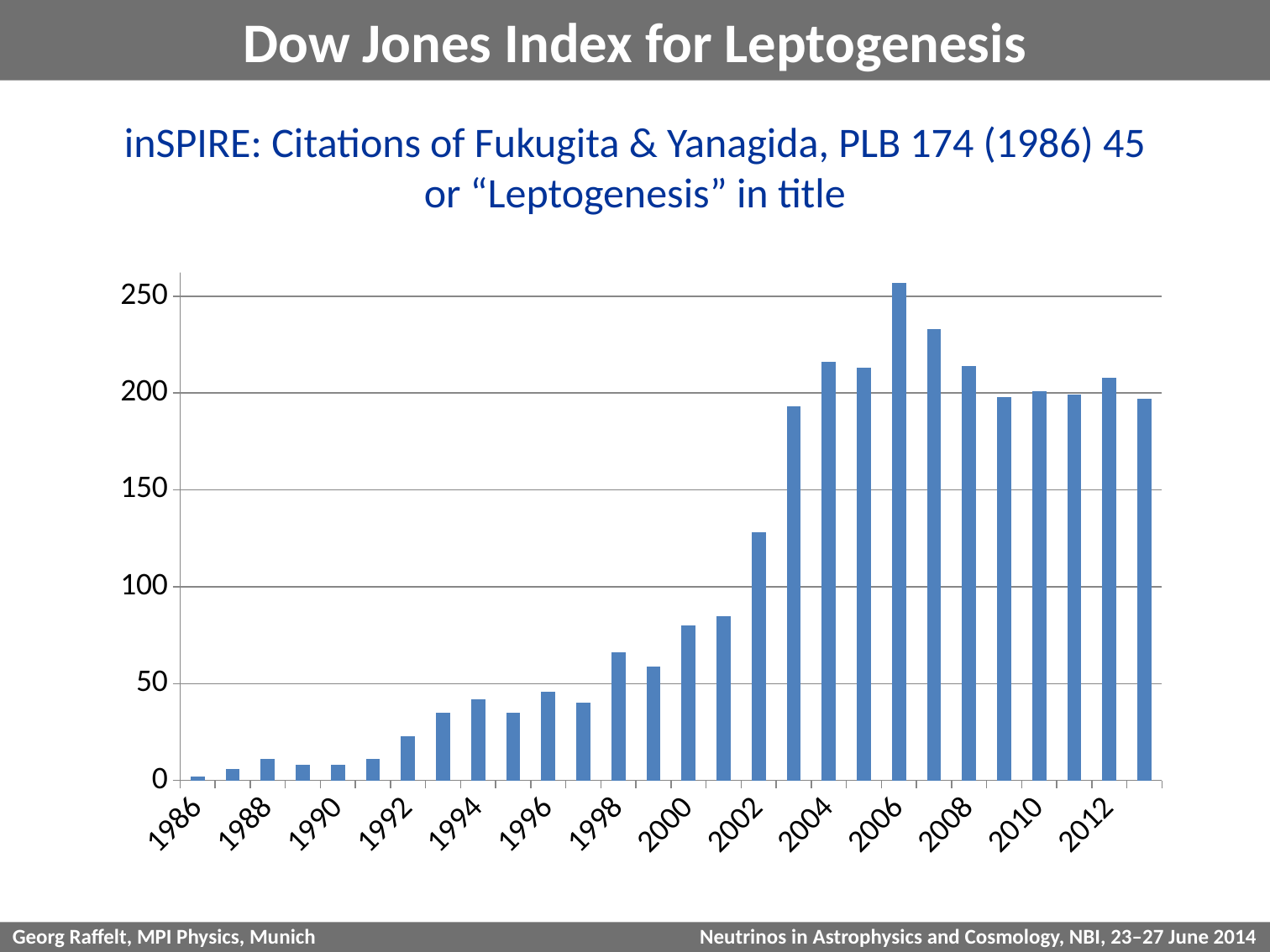
What kind of chart is shown on the slide? bar chart Is the value for 2002 greater or less than 100? greater How many bars (years) are plotted in the chart? 28 Do the values generally rise or fall from 1986 to 2006? rise Which year has the highest bar in the chart? 2006 Which is larger, the value for 2002 or the value for 2003? 2003 Is the value for 1992 greater or less than 50? less Is the value for 2000 greater or less than 100? less What is the highest tick value shown on the vertical axis? 250 Which year has the lowest bar in the chart? 1986 Which is larger, the value for 2006 or the value for 2007? 2006